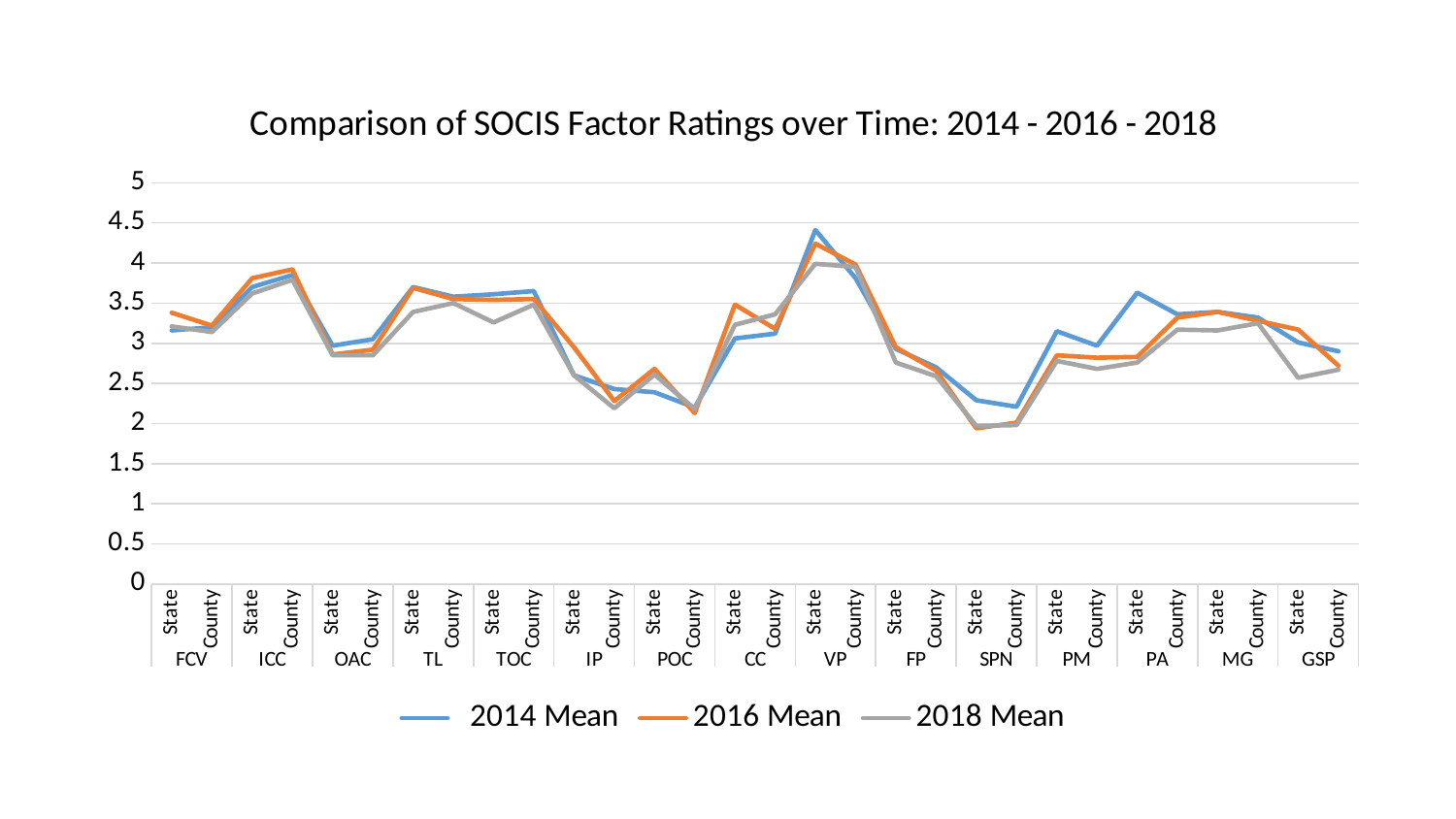
How many SOCIS factor groups are shown along the x axis? 15 Is the 2014 Mean value for VP State greater or less than 4? greater For the 2018 Mean series, which is larger: the value at TOC County or the value at IP State? TOC County For the 2014 Mean series, at which point is the value highest? VP State At PA State, which is larger: the 2014 Mean or the 2016 Mean? 2014 Mean What kind of chart is shown on the slide? line chart Is the 2016 Mean value for ICC County greater or less than 3.5? greater Do the values rise or fall from VP State to SPN State? fall How many series does the legend list? 3 What is the title of the chart? Comparison of SOCIS Factor Ratings over Time: 2014 - 2016 - 2018 Is the 2018 Mean value for IP County greater or less than 2.5? less